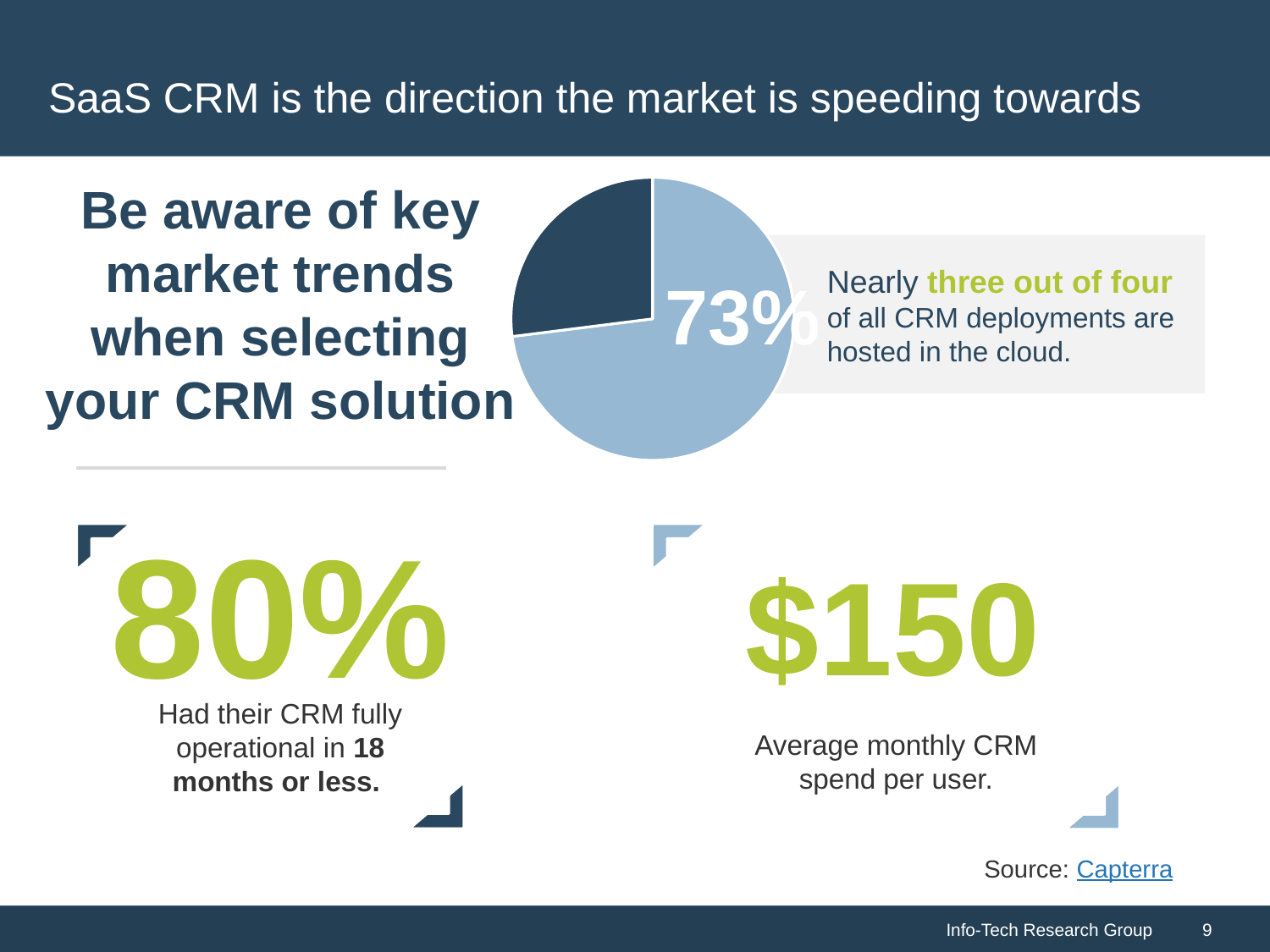
What share of the pie does the dark blue slice represent? 27% Which slice of the pie chart is larger, the light blue one or the dark blue one? The light blue one Is the light blue slice of the pie chart greater or less than 50%? greater What percentage is labeled on the pie chart? 73% What does the 73% slice of the pie chart represent? CRM deployments hosted in the cloud What kind of chart is shown on the slide? Pie chart What colour is the 73% slice of the pie chart? Light blue How many slices does the pie chart have? 2 Is the dark blue slice of the pie chart greater or less than 50%? less What share of the pie does the light blue slice represent? 73%